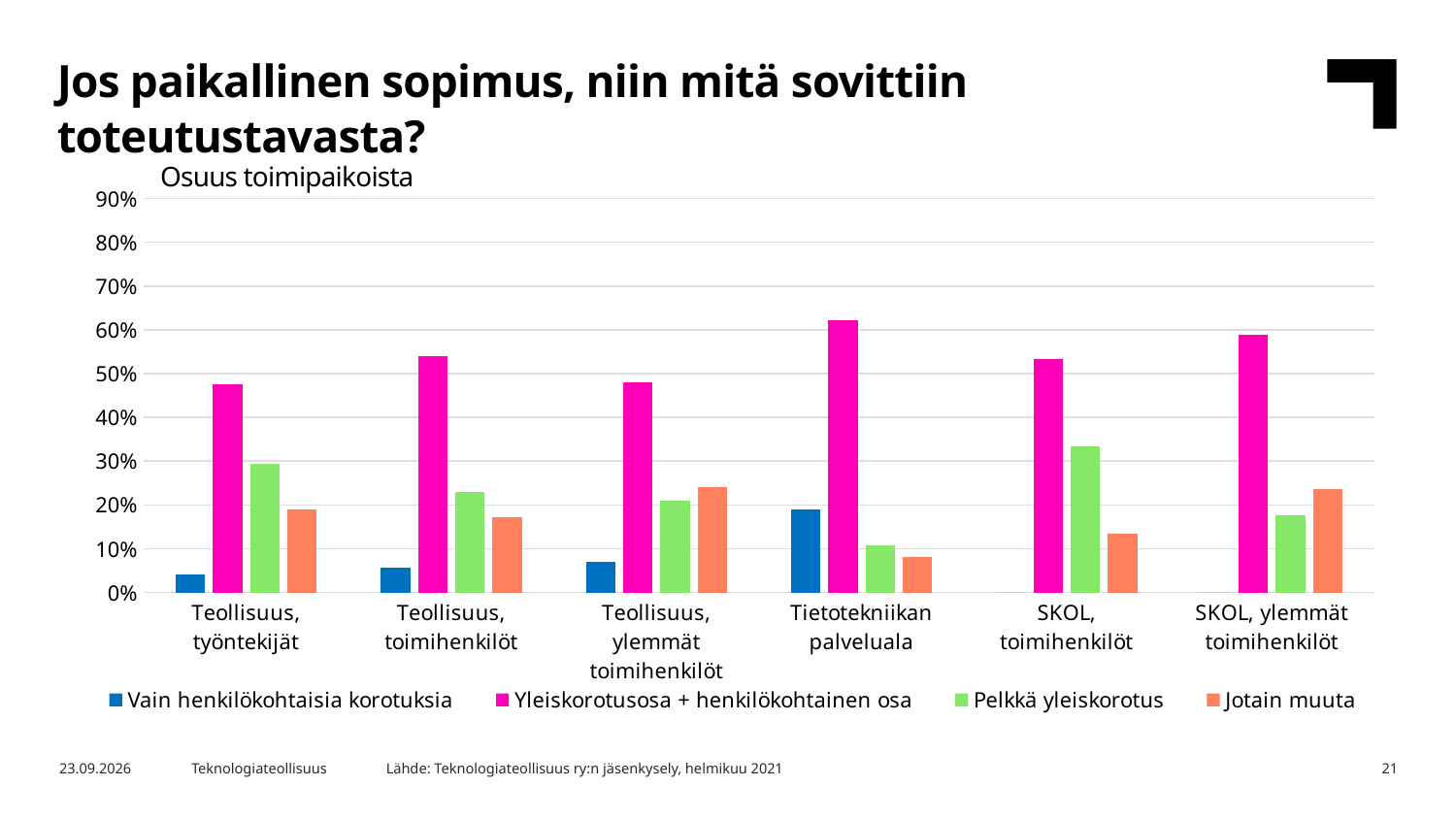
Which category has the highest value for 'Yleiskorotusosa + henkilökohtainen osa'? Tietotekniikan palveluala Is the value for 'Pelkkä yleiskorotus' in SKOL, toimihenkilöt greater or less than 30%? greater How many series does the legend list? 4 Which category has the lowest value for 'Jotain muuta'? Tietotekniikan palveluala Is the value for 'Vain henkilökohtaisia korotuksia' in Tietotekniikan palveluala greater or less than 10%? greater How many categories are shown on the x axis of the chart? 6 Which category has the highest value for 'Vain henkilökohtaisia korotuksia'? Tietotekniikan palveluala Is the value for 'Yleiskorotusosa + henkilökohtainen osa' in Tietotekniikan palveluala greater or less than 60%? greater What kind of chart is shown on the slide? bar chart Which category has the highest value for 'Pelkkä yleiskorotus'? SKOL, toimihenkilöt What is the title shown above the vertical axis of the chart? Osuus toimipaikoista For Teollisuus, työntekijät, which is larger: 'Pelkkä yleiskorotus' or 'Jotain muuta'? Pelkkä yleiskorotus